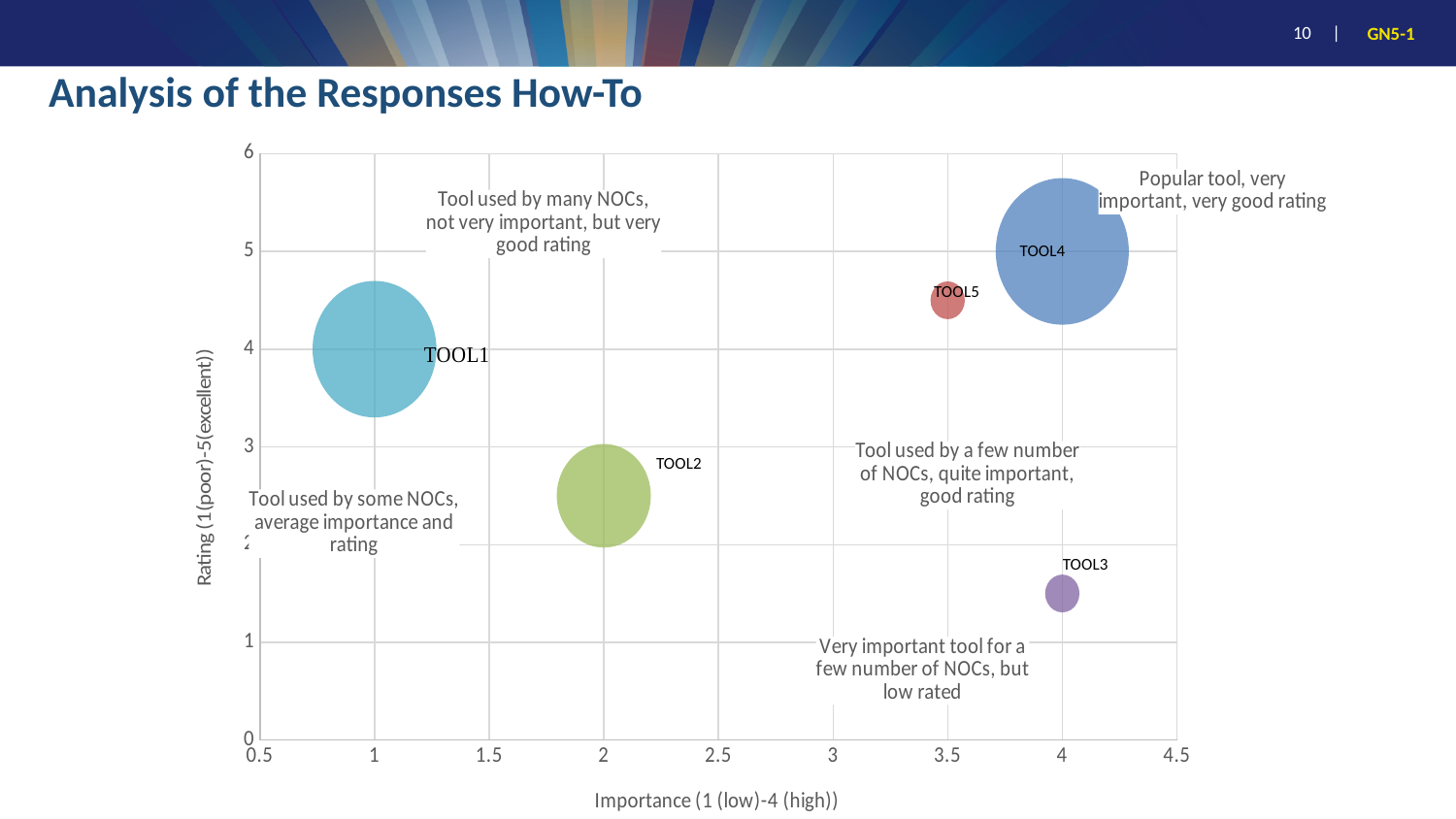
Which tool has the lowest rating? TOOL3 Which tool has the lowest importance? TOOL1 How many tools are plotted on the chart? 5 What is the rating value for TOOL4? 5 What is the rating value for TOOL1? 4 Which tool has the highest rating? TOOL4 What is the importance value for TOOL1? 1 What kind of chart is shown on the slide? Bubble chart What is the title of the chart's x axis? Importance (1 (low)-4 (high)) Which has the higher rating, TOOL2 or TOOL1? TOOL1 Is the importance for TOOL5 greater or less than 3? greater Is the rating for TOOL3 greater or less than 2? less